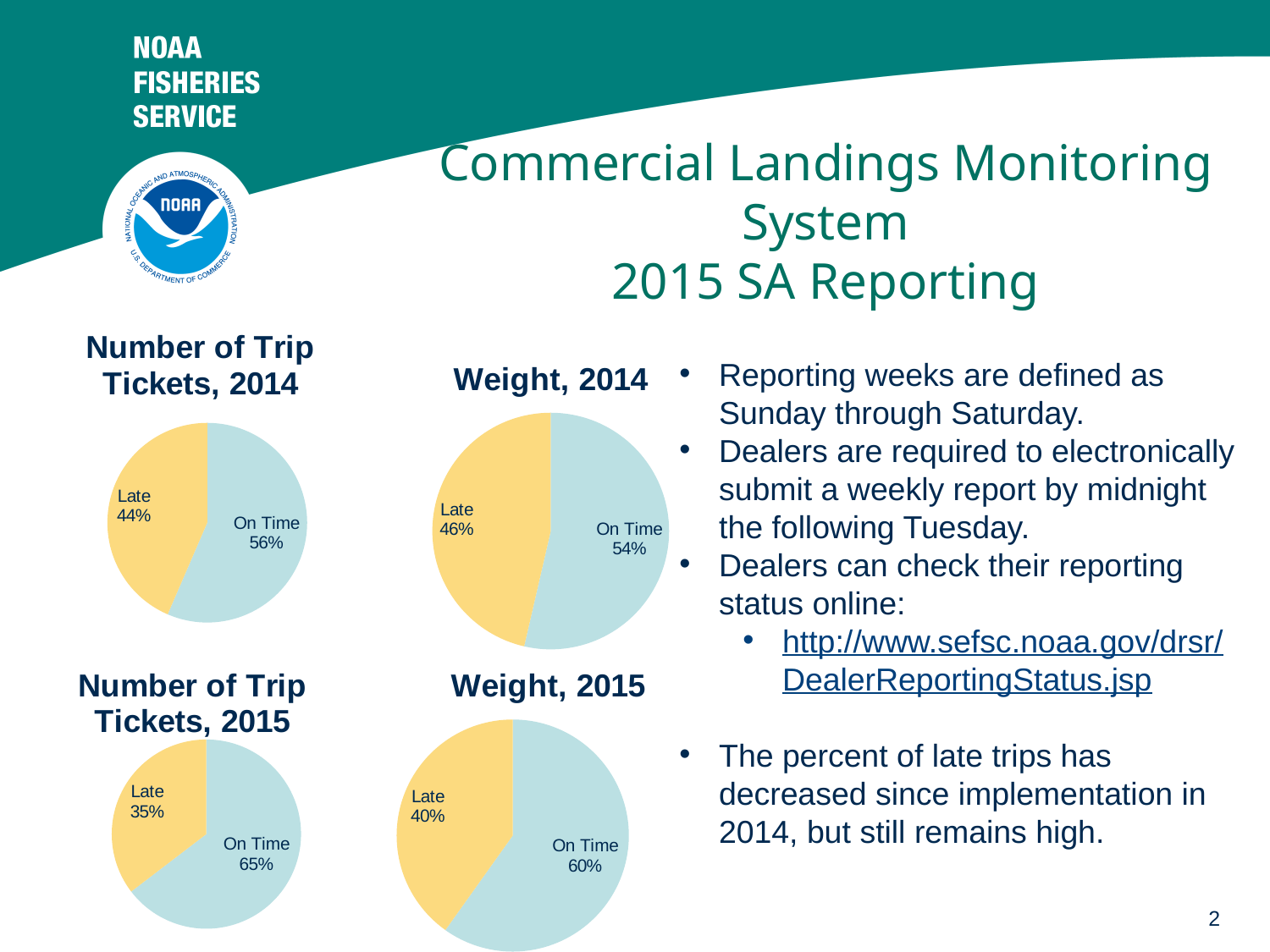
In the 'Number of Trip Tickets, 2014' chart, what share of trip tickets were Late? 44% In the 'Weight, 2014' chart, what share of weight was Late? 46% In the 'Weight, 2014' chart, which slice is the largest? On Time In the 'Number of Trip Tickets, 2014' chart, what share of trip tickets were On Time? 56% In the 'Number of Trip Tickets, 2014' chart, what is the difference between the On Time and Late shares? 12% In the 'Weight, 2015' chart, what is the difference between the On Time and Late shares? 20% How many slices does the 'Number of Trip Tickets, 2015' chart have? 2 In the 'Number of Trip Tickets, 2015' chart, which slice is larger, Late or On Time? On Time What kind of chart is the 'Weight, 2015' chart? Pie chart How many pie charts are shown on the slide? 4